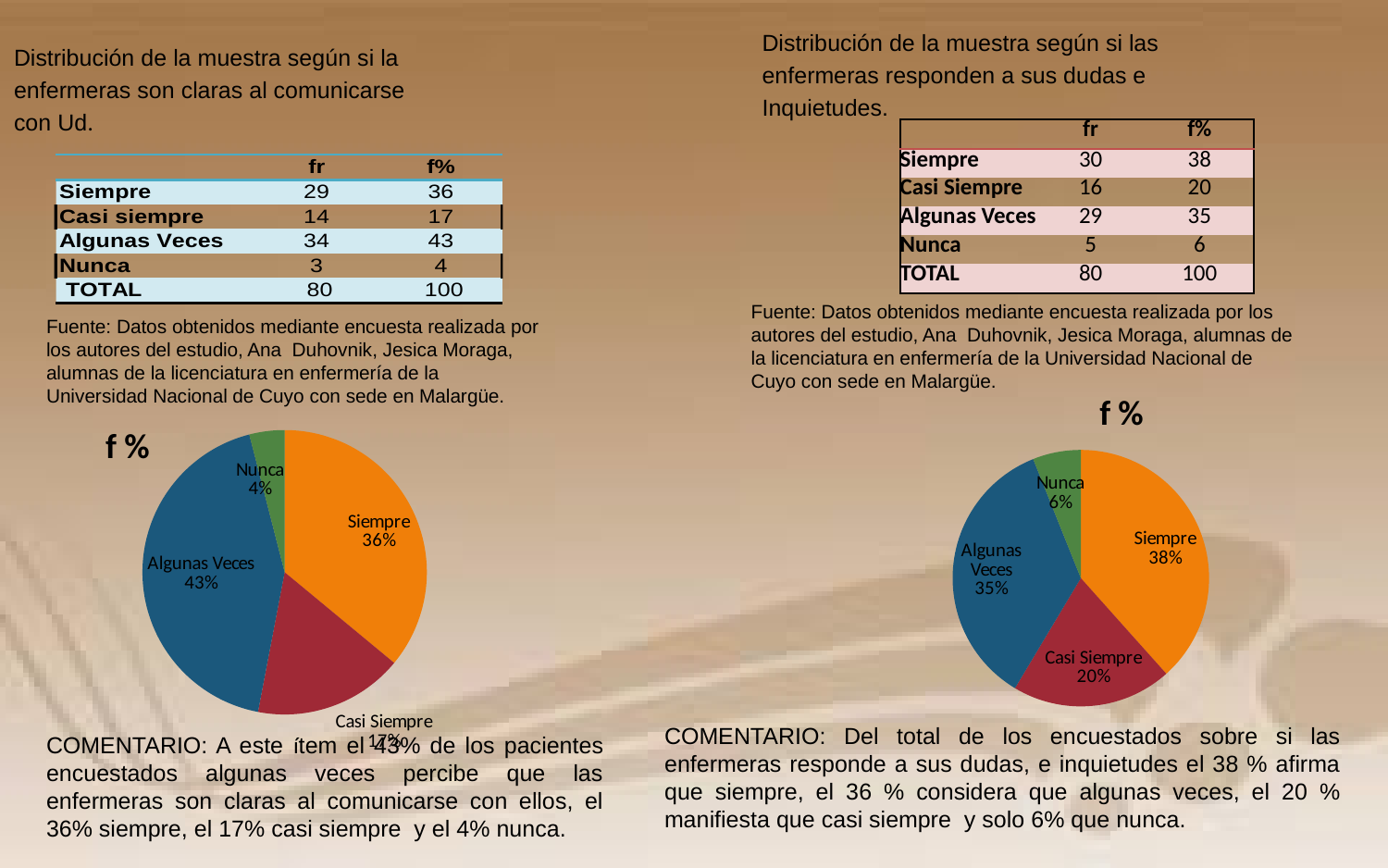
What is the title of the right pie chart? f % In the right pie chart, which category has the largest slice? Siempre In the left pie chart, which is larger, Siempre or Casi Siempre? Siempre In the right pie chart, what is the difference between the Siempre and Algunas Veces shares? 3% In the left pie chart, which category has the largest slice? Algunas Veces How many slices does the right pie chart have? 4 In the right pie chart, what is the share for Nunca? 6% In the left pie chart, which category has the smallest slice? Nunca What type of chart is shown on the left side of the slide? Pie chart In the left pie chart, what is the share for Siempre? 36% In the left pie chart, what is the share for Algunas Veces? 43% In the right pie chart, what is the share for Casi Siempre? 20%